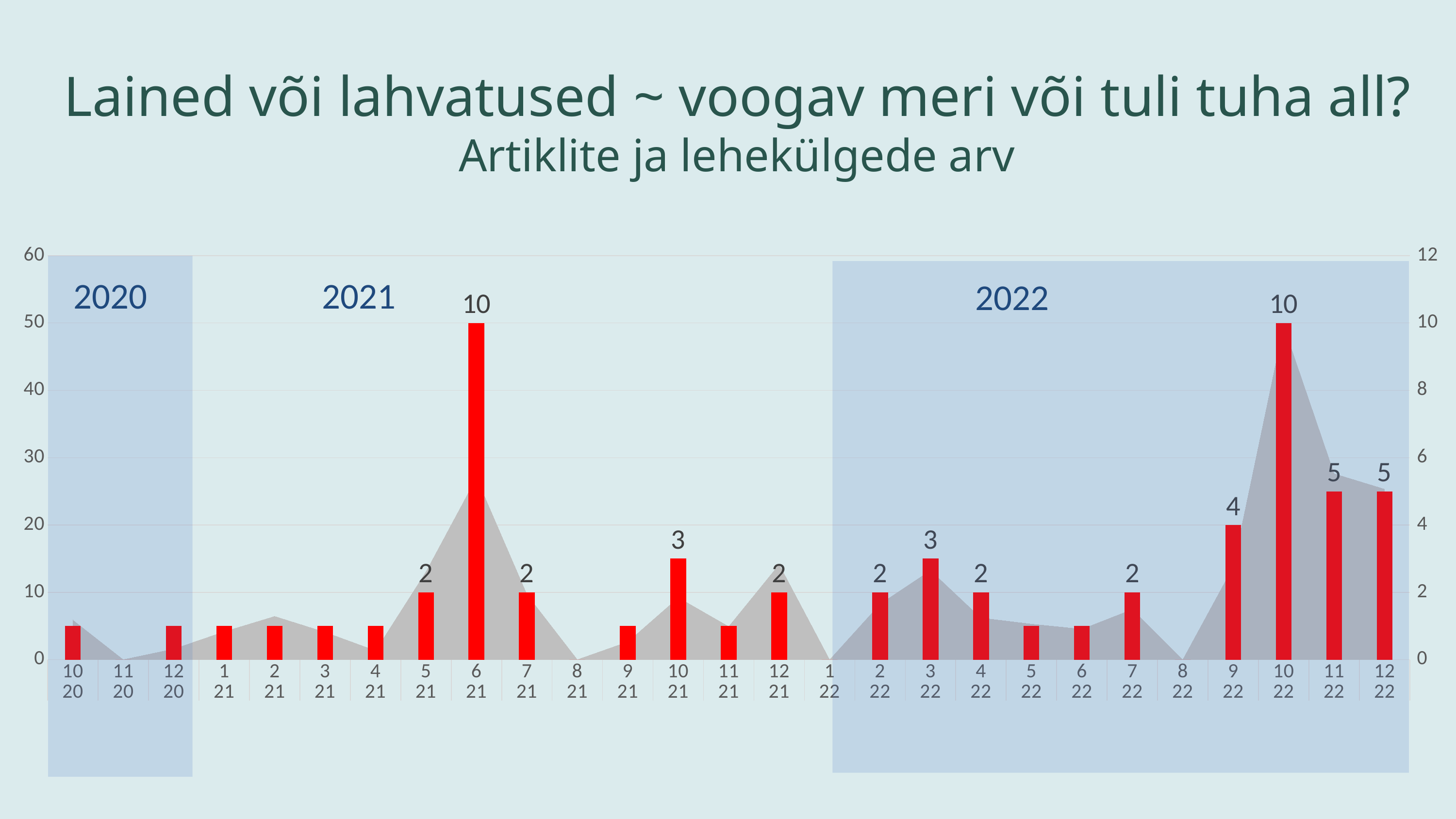
What is the value of the red bar for 10 21? 3 On the left axis, is the grey area value for 10 22 greater or less than 40? greater What is the value of the red bar for 9 22? 4 What is the subtitle of the chart below the main title? Artiklite ja lehekülgede arv How many months are shown on the x axis? 27 Which has the larger red bar, 3 22 or 9 22? 9 22 What is the value of the red bar for 11 22? 5 What is the difference between the red bar values for 10 22 and 9 22? 6 What is the value of the red bar for 6 21? 10 On the left axis, is the grey area value for 6 21 greater or less than 20? greater What is the highest value shown on a red bar? 10 Do the red bar values rise or fall from 10 22 to 12 22? fall